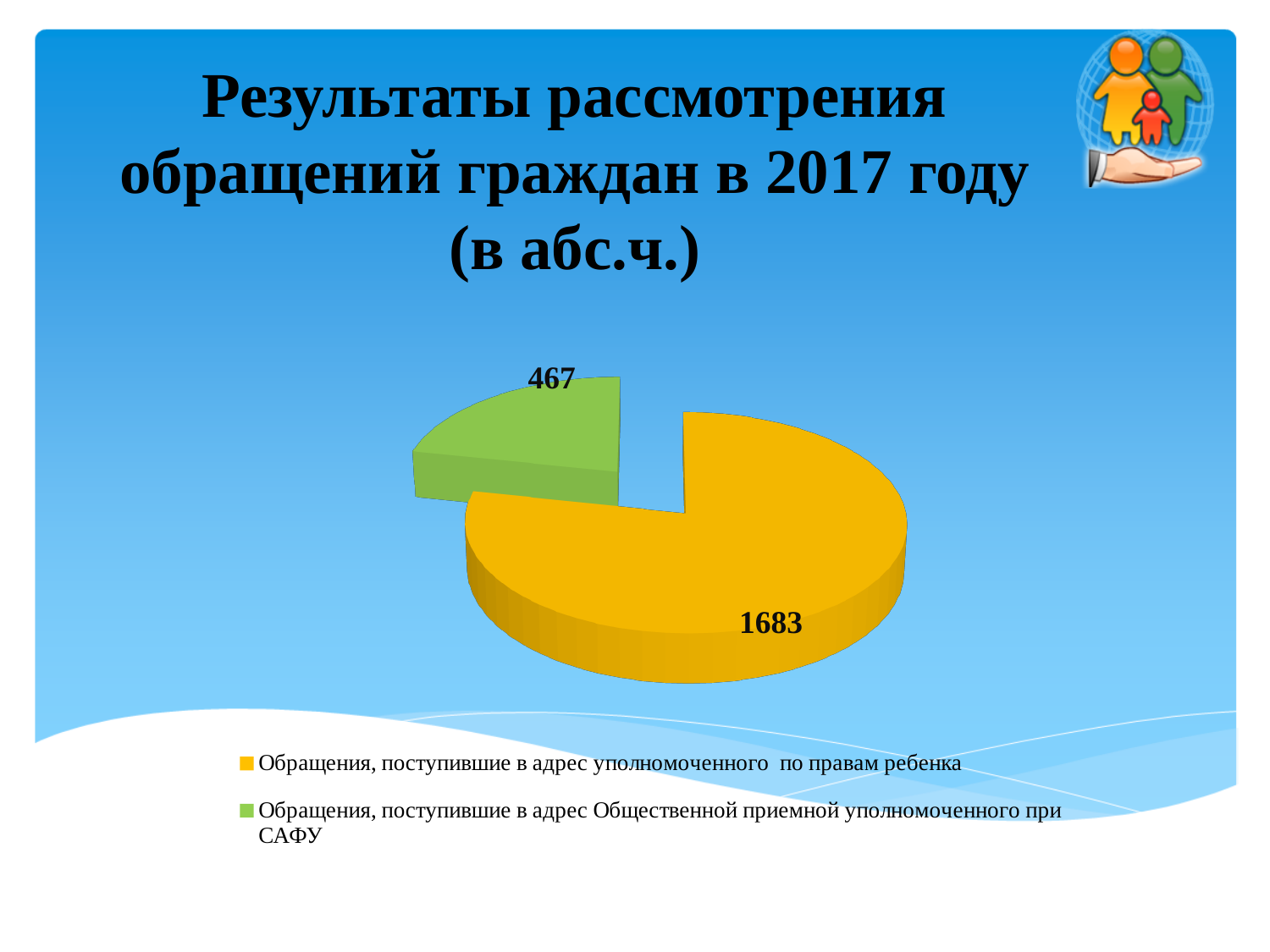
What is the value for "Обращения, поступившие в адрес уполномоченного по правам ребенка"? 1683 Which category has the largest slice of the pie? Обращения, поступившие в адрес уполномоченного по правам ребенка Which category has the smallest slice of the pie? Обращения, поступившие в адрес Общественной приемной уполномоченного при САФУ What is the title of the slide containing the chart? Результаты рассмотрения обращений граждан в 2017 году (в абс.ч.) How many entries does the legend list? 2 What colour is the slice for "Обращения, поступившие в адрес Общественной приемной уполномоченного при САФУ"? green What kind of chart is shown on the slide? pie chart How many slices does the pie chart have? 2 Which is larger: the value for appeals to the ombudsman for children's rights or the value for appeals to the public reception at САФУ? appeals to the ombudsman for children's rights (1683) What is the total of the two values shown on the pie chart? 2150 What is the difference between the two values shown on the pie chart? 1216 What is the value for "Обращения, поступившие в адрес Общественной приемной уполномоченного при САФУ"? 467